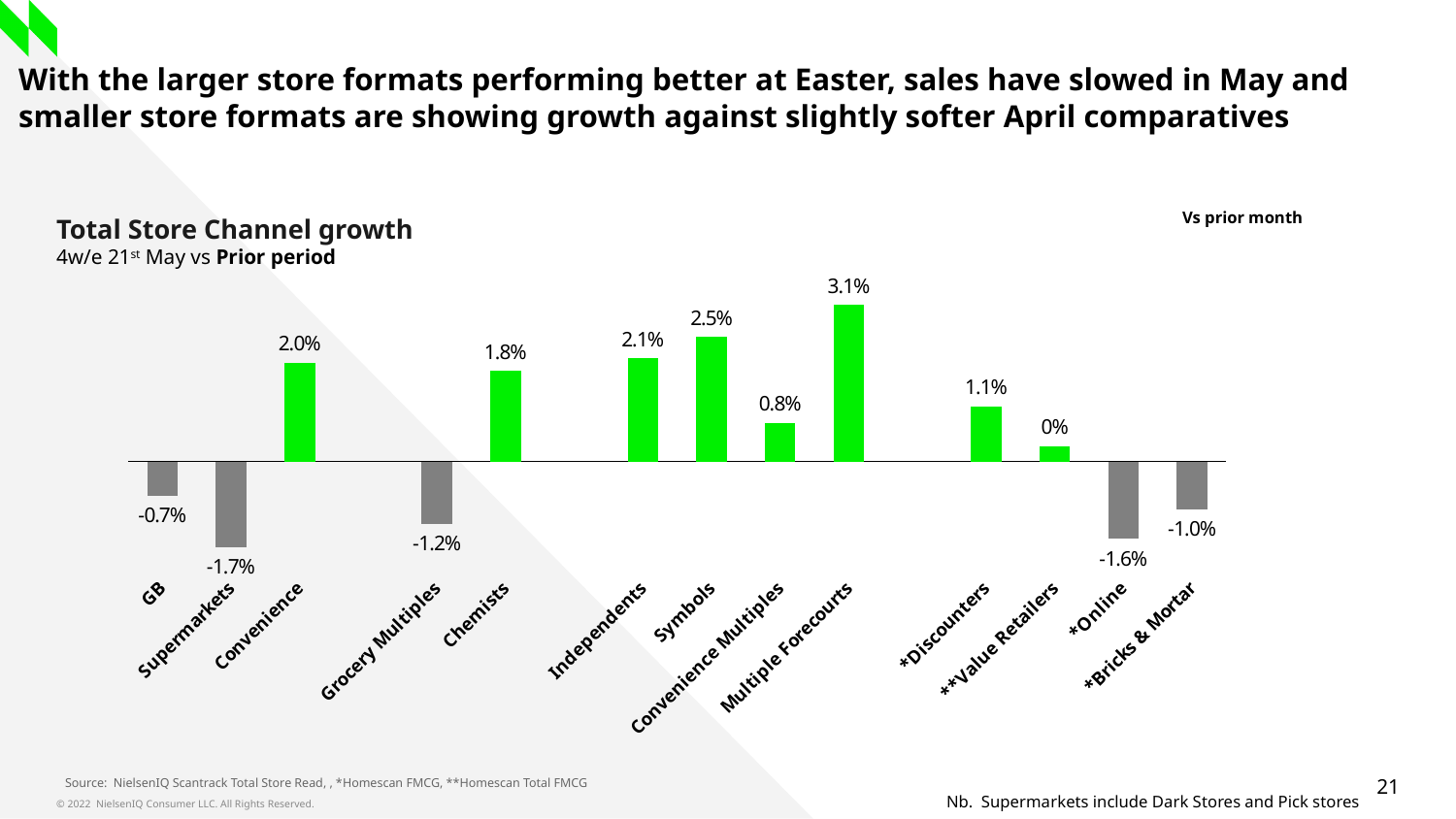
What is the growth value shown for Supermarkets? -1.7% What is the Total Store Channel growth value for Multiple Forecourts? 3.1% What is the growth value shown for Online? -1.6% Which has the higher growth, Discounters or Convenience Multiples? Discounters What type of chart is shown on the slide? Bar chart What is the difference between the growth for Convenience and the growth for Chemists? 0.2% What is the difference between the growth for Symbols and the growth for Independents? 0.4% Which channel has the lowest growth in the chart? Supermarkets What is the title of the chart? Total Store Channel growth Which channel has the highest growth in the chart? Multiple Forecourts How many channel categories are plotted in the chart? 13 What is the growth value shown for Value Retailers? 0%